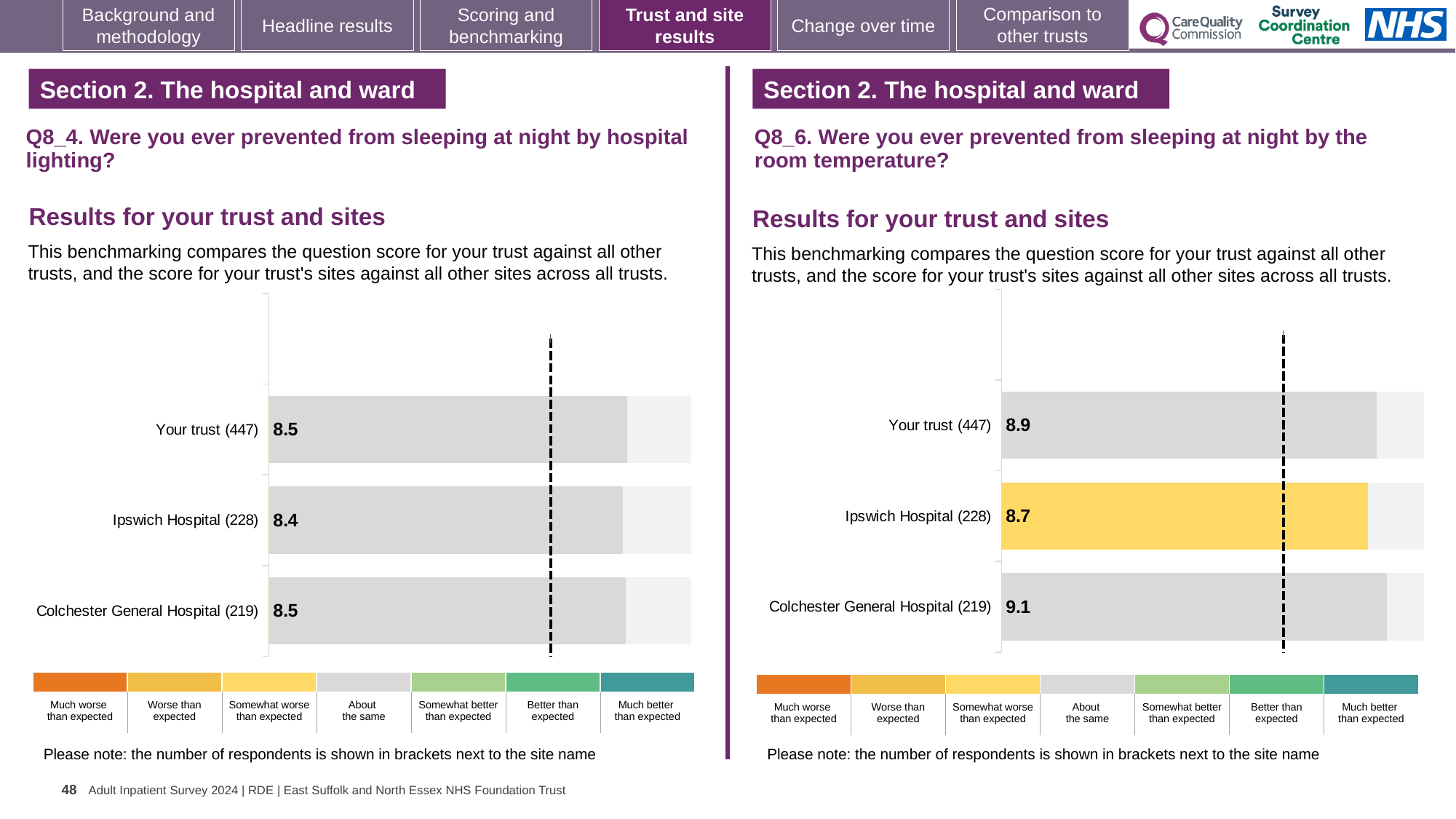
In the Q8_6 chart (room temperature), is the score for Your trust or Ipswich Hospital higher? Your trust In the Q8_4 chart (hospital lighting), what is the difference between the scores for Your trust and Ipswich Hospital? 0.1 How many bars are plotted in the Q8_4 chart (hospital lighting)? 3 In the Q8_6 chart (room temperature), what is the score for Colchester General Hospital (219)? 9.1 In the Q8_4 chart (hospital lighting), which has the lowest score? Ipswich Hospital (228) In the Q8_6 chart (room temperature), what is the difference between the scores for Colchester General Hospital and Ipswich Hospital? 0.4 In the Q8_6 chart (room temperature), which site or trust has the highest score? Colchester General Hospital (219) In the Q8_6 chart (room temperature), what is the score for Your trust (447)? 8.9 In the Q8_6 chart (room temperature), which site or trust has the lowest score? Ipswich Hospital (228) In the Q8_4 chart (hospital lighting), what is the score for Ipswich Hospital (228)? 8.4 In the Q8_6 chart (room temperature), which benchmark category does the yellow bar for Ipswich Hospital represent? Somewhat worse than expected In the Q8_4 chart (hospital lighting), what is the score for Your trust (447)? 8.5